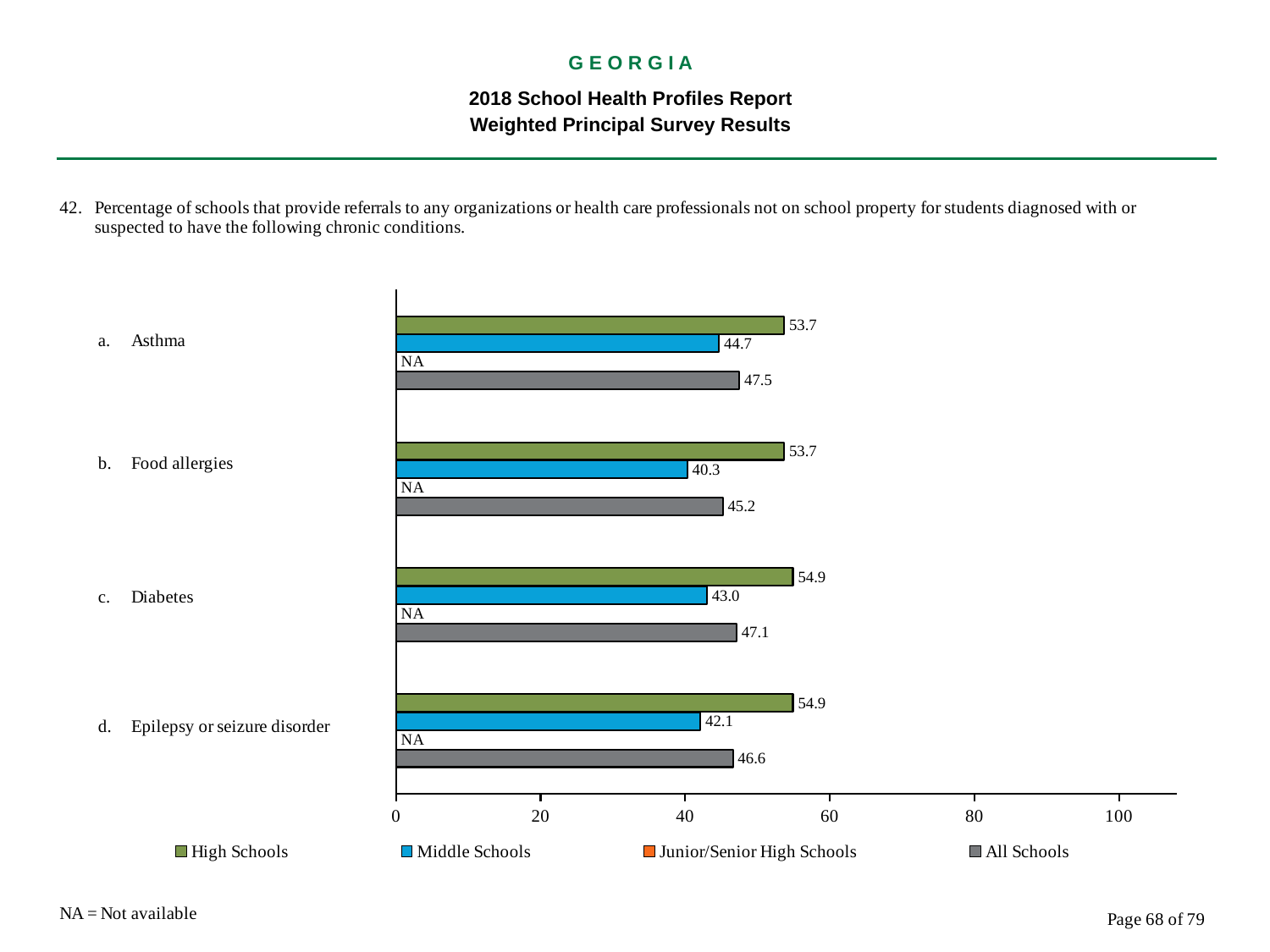
What is the difference between the High Schools and Middle Schools values for Food allergies? 13.4 What kind of chart is shown on the slide? Bar chart How many chronic conditions are listed on the chart? 4 What is the High Schools value for Asthma? 53.7 What is the Middle Schools value for Epilepsy or seizure disorder? 42.1 Which chronic condition has the lowest Middle Schools value? Food allergies What is the Middle Schools value for Food allergies? 40.3 Which is larger for Diabetes: the Middle Schools value or the All Schools value? All Schools How many series does the legend list? 4 What value is shown for Junior/Senior High Schools for Asthma? NA Which chronic condition has the highest All Schools value? Asthma What is the All Schools value for Diabetes? 47.1